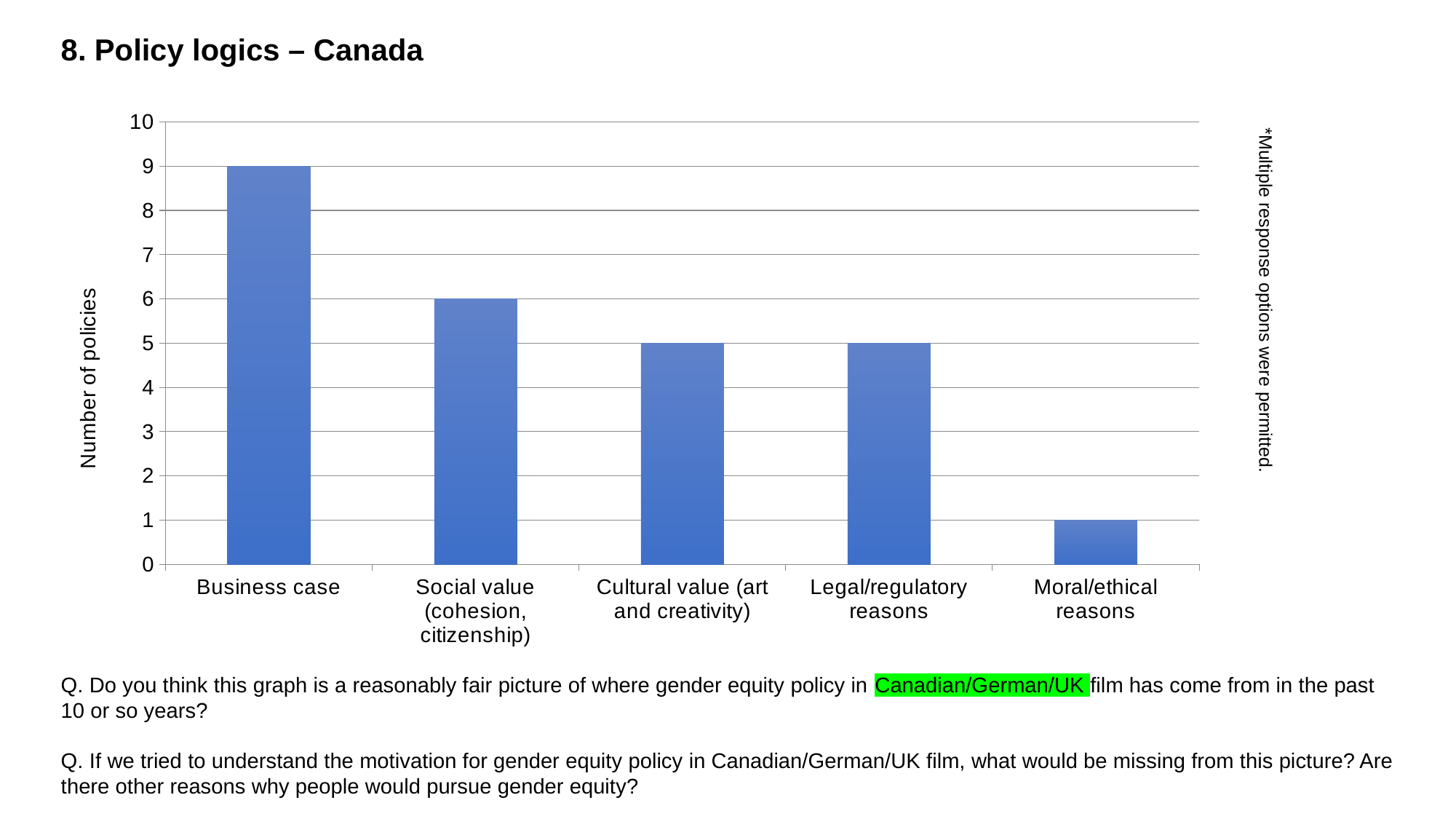
Which category has the lowest number of policies? Moral/ethical reasons Which category has the highest number of policies? Business case What is the maximum value shown on the y axis? 10 How many categories are shown on the x axis of the chart? 5 What is the number of policies for Social value (cohesion, citizenship)? 6 What is the label of the y axis? Number of policies What is the number of policies for Business case? 9 Is the value for Cultural value (art and creativity) greater or less than 8? less Which has more policies, Social value (cohesion, citizenship) or Legal/regulatory reasons? Social value (cohesion, citizenship) What kind of chart is shown on the slide? bar chart What is the number of policies for Moral/ethical reasons? 1 What is the difference in number of policies between Business case and Social value (cohesion, citizenship)? 3